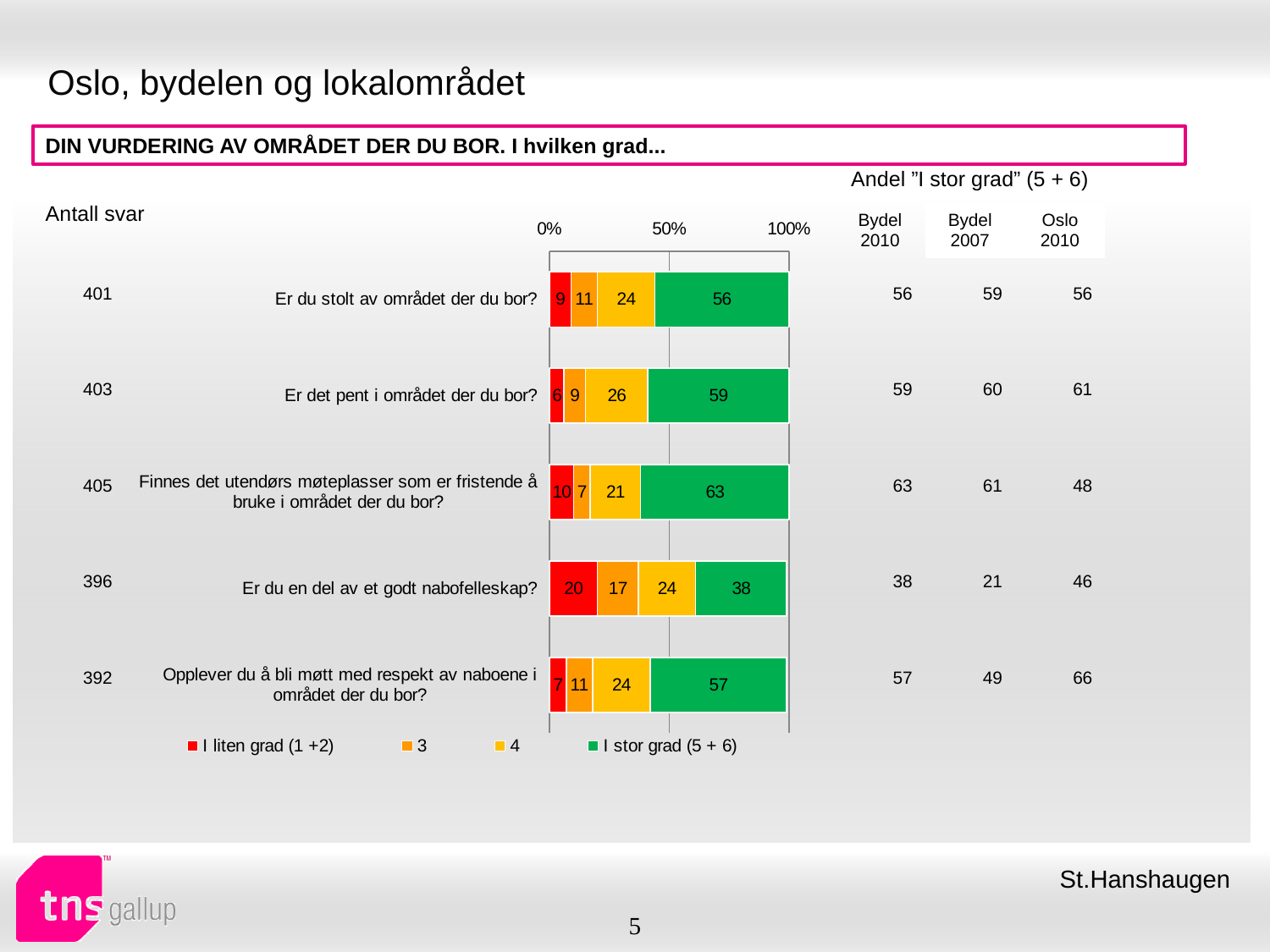
What is the value of "I liten grad (1 +2)" for "Er du en del av et godt nabofelleskap?"? 20 Which question has the lowest value for "I stor grad (5 + 6)"? Er du en del av et godt nabofelleskap? What is the value of series "3" for "Opplever du å bli møtt med respekt av naboene i området der du bor?"? 11 What is the value of series "4" for "Er det pent i området der du bor?"? 26 Which question has the highest value for "I stor grad (5 + 6)"? Finnes det utendørs møteplasser som er fristende å bruke i området der du bor? Which has a larger "I liten grad (1 +2)" value: "Er du stolt av området der du bor?" or "Er det pent i området der du bor?"? Er du stolt av området der du bor? What is the total of the stacked bar for "Er du en del av et godt nabofelleskap?"? 99 How many series does the legend list? 4 What is the difference between the "I stor grad (5 + 6)" values for "Er det pent i området der du bor?" and "Er du en del av et godt nabofelleskap?"? 21 How many questions (categories) are plotted in the chart? 5 What kind of chart is shown on the slide? stacked bar chart What is the value of "I stor grad (5 + 6)" for "Er du stolt av området der du bor?"? 56